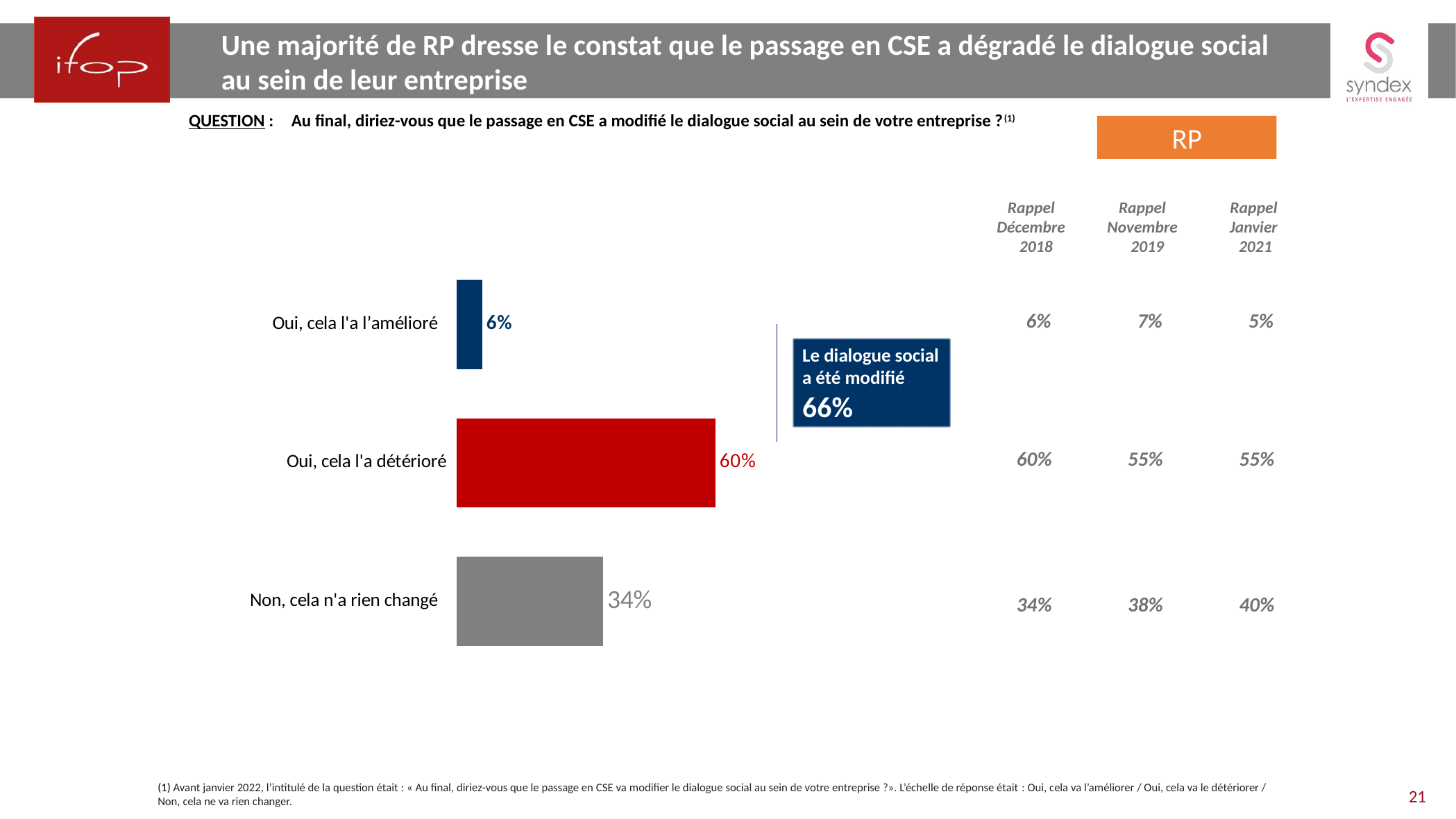
Which response category has the highest value in the bar chart? Oui, cela l'a détérioré What kind of chart is shown on the slide? Bar chart What is the difference between the values for "Oui, cela l'a détérioré" and "Non, cela n'a rien changé"? 26 percentage points What percentage of respondents answered "Oui, cela l'a détérioré"? 60% What colour is the bar for "Oui, cela l'a détérioré"? Red What is the combined share of respondents who said the social dialogue was modified ("Le dialogue social a été modifié")? 66% Which response category has the lowest value in the bar chart? Oui, cela l'a amélioré What percentage of respondents answered "Non, cela n'a rien changé"? 34% How many response categories are shown in the bar chart? 3 What was the value for "Non, cela n'a rien changé" in the Rappel Janvier 2021 column? 40% Which is larger: the value for "Non, cela n'a rien changé" or the value for "Oui, cela l'a amélioré"? Non, cela n'a rien changé What percentage of respondents answered "Oui, cela l'a amélioré"? 6%